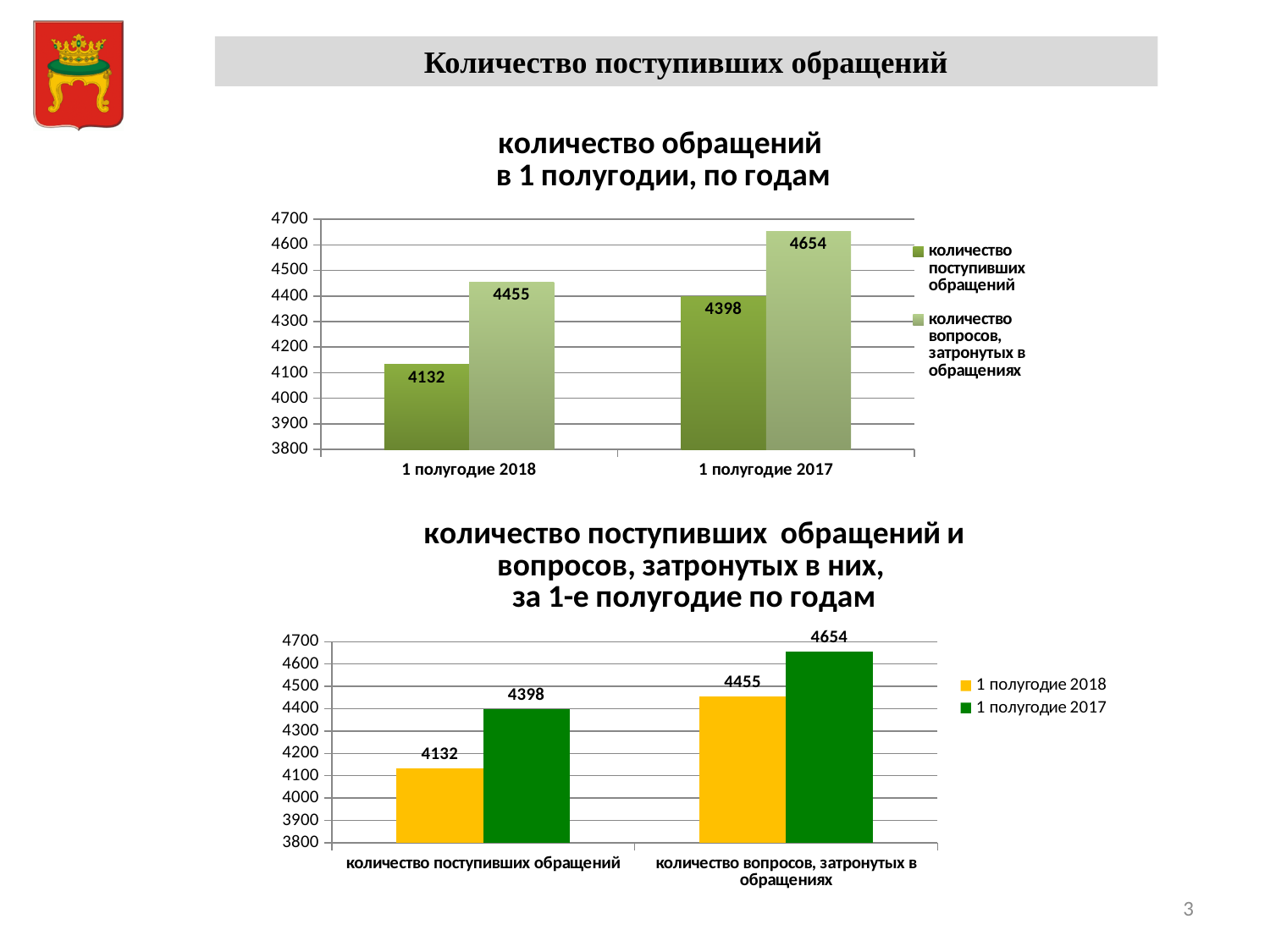
How many series does the legend of the top chart list? 2 In the bottom chart, what is the difference between the '1 полугодие 2017' and '1 полугодие 2018' values for 'количество вопросов, затронутых в обращениях'? 199 What type of chart is the top chart? Bar chart In the top chart, what is the value of 'количество поступивших обращений' for '1 полугодие 2018'? 4132 In the bottom chart, which series has the lower value in the category 'количество поступивших обращений'? 1 полугодие 2018 How many categories are shown on the x axis of the bottom chart? 2 In the top chart, what is the difference between 'количество поступивших обращений' for '1 полугодие 2017' and for '1 полугодие 2018'? 266 In the top chart, which category has the higher value for 'количество вопросов, затронутых в обращениях'? 1 полугодие 2017 In the bottom chart, what is the value for '1 полугодие 2017' in the category 'количество поступивших обращений'? 4398 In the bottom chart, what colour are the bars for '1 полугодие 2018'? Yellow In the top chart, what is the value of 'количество вопросов, затронутых в обращениях' for '1 полугодие 2017'? 4654 In the bottom chart, what is the value for '1 полугодие 2018' in the category 'количество вопросов, затронутых в обращениях'? 4455